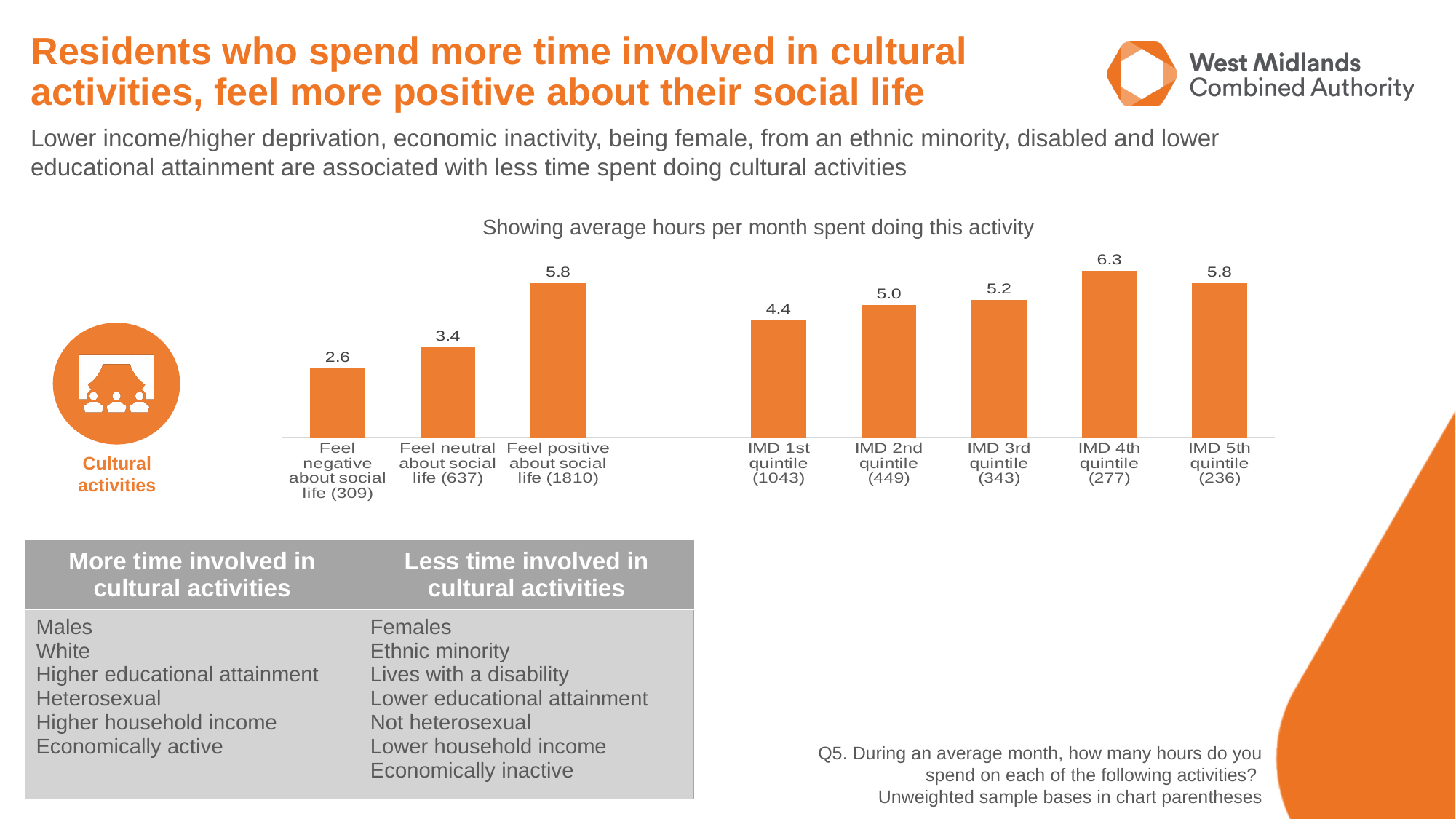
In the left chart, do the values rise or fall from feeling negative to feeling positive about social life? Rise In the left chart, what is the difference between the values for feeling positive and feeling negative about social life? 3.2 In the right chart, what is the difference between IMD 4th quintile and IMD 1st quintile? 1.9 In the left chart, what is the value for residents who feel positive about social life? 5.8 In the right chart, which is larger: IMD 5th quintile or IMD 3rd quintile? IMD 5th quintile What type of chart is used on the slide? Bar chart In the right chart, what is the value for IMD 4th quintile? 6.3 How many bars are in the right chart? 5 In the left chart, what is the average hours per month for residents who feel negative about social life? 2.6 In the left chart, which category has the lowest value? Feel negative about social life In the right chart, what is the value for IMD 1st quintile? 4.4 In the right chart, which IMD quintile has the highest average hours per month? IMD 4th quintile